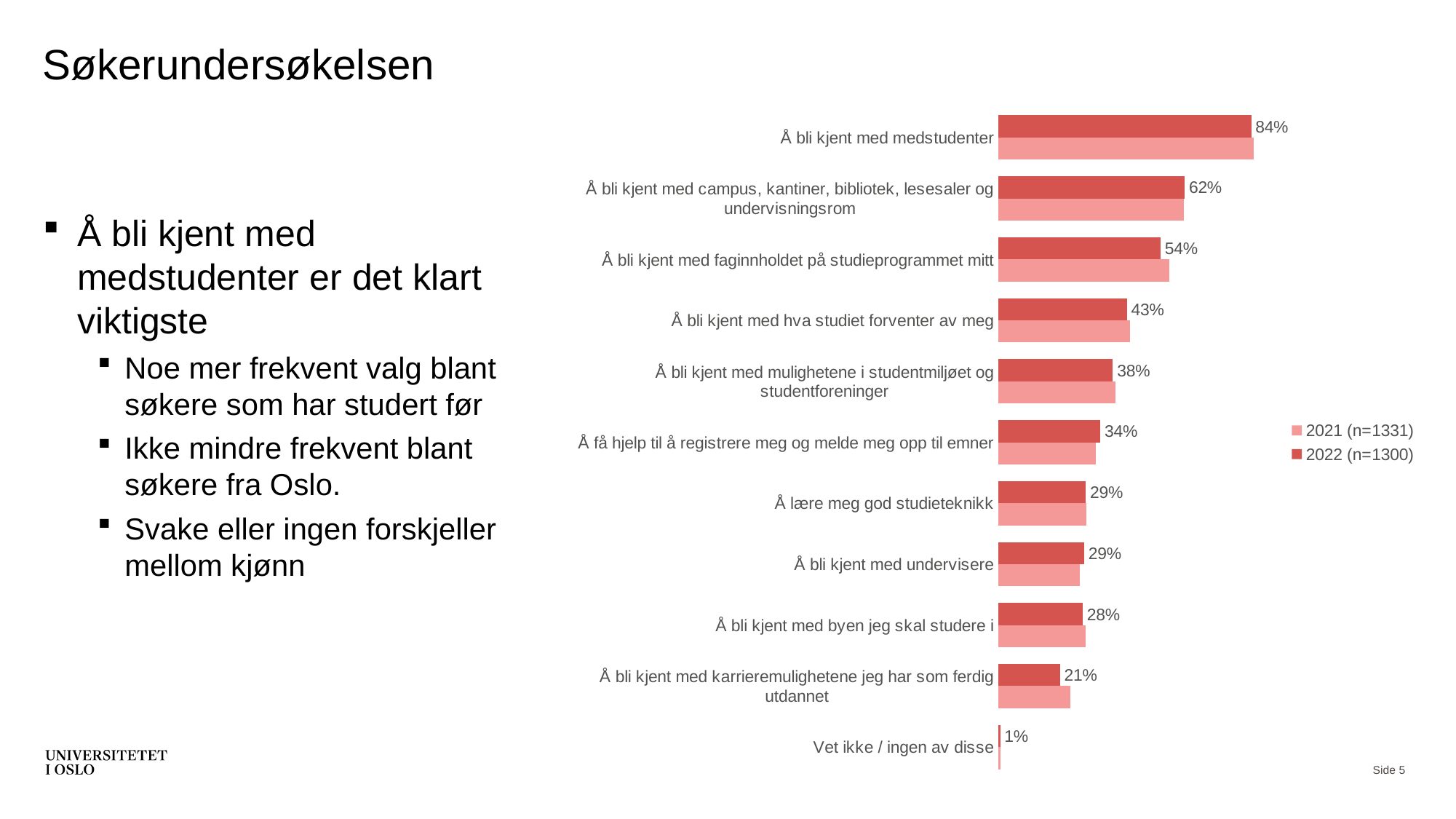
Which category has the lowest 2022 value? Vet ikke / ingen av disse How many series does the chart legend list? 2 Which category has the highest 2022 value? Å bli kjent med medstudenter What is the 2022 value for "Å bli kjent med faginnholdet på studieprogrammet mitt"? 54% What is the 2022 value for "Å bli kjent med medstudenter"? 84% What kind of chart is shown on the slide? bar chart What is the difference between the 2022 values for "Å bli kjent med medstudenter" and "Å bli kjent med campus, kantiner, bibliotek, lesesaler og undervisningsrom"? 22% Which has a larger 2022 value: "Å bli kjent med hva studiet forventer av meg" or "Å bli kjent med undervisere"? Å bli kjent med hva studiet forventer av meg What is the 2022 value for "Å få hjelp til å registrere meg og melde meg opp til emner"? 34% What sample size does the legend give for the 2022 series? n=1300 How many categories are shown in the chart? 11 What is the 2022 value for "Å bli kjent med karrieremulighetene jeg har som ferdig utdannet"? 21%